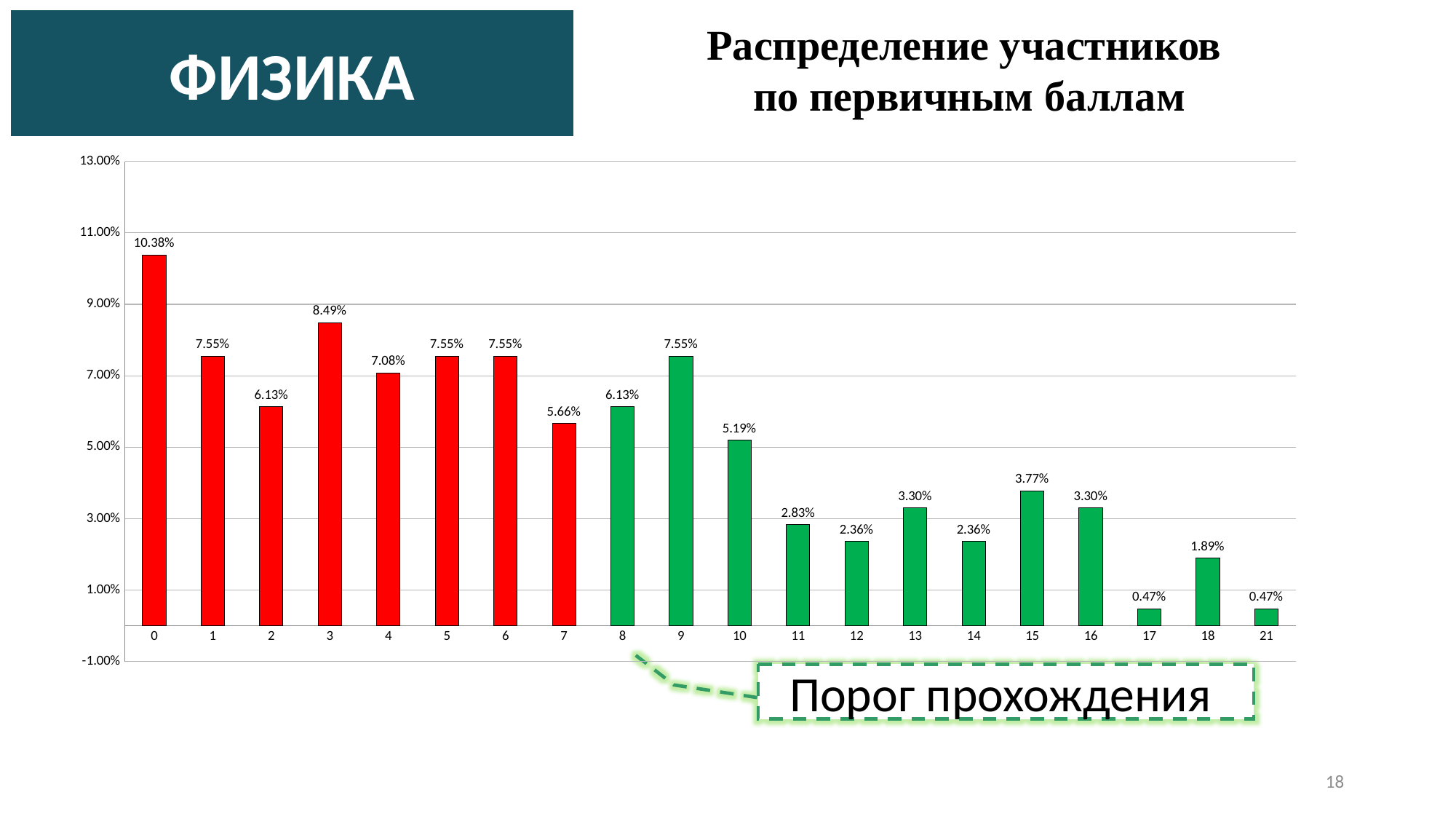
Which score has the highest share of participants? 0 What is the value for score 10? 5.19% How many bars are shown on the chart? 20 What is the difference between the values for score 0 and score 3? 1.89% What is the value for score 18? 1.89% What is the value for score 0? 10.38% What colour are the bars for scores 0 through 7? red What kind of chart is shown on the slide? bar chart Which is larger, the value for score 7 or the value for score 8? score 8 What is the difference between the values for score 15 and score 16? 0.47% What is the lowest value shown on the chart? 0.47% What is the value for score 3? 8.49%